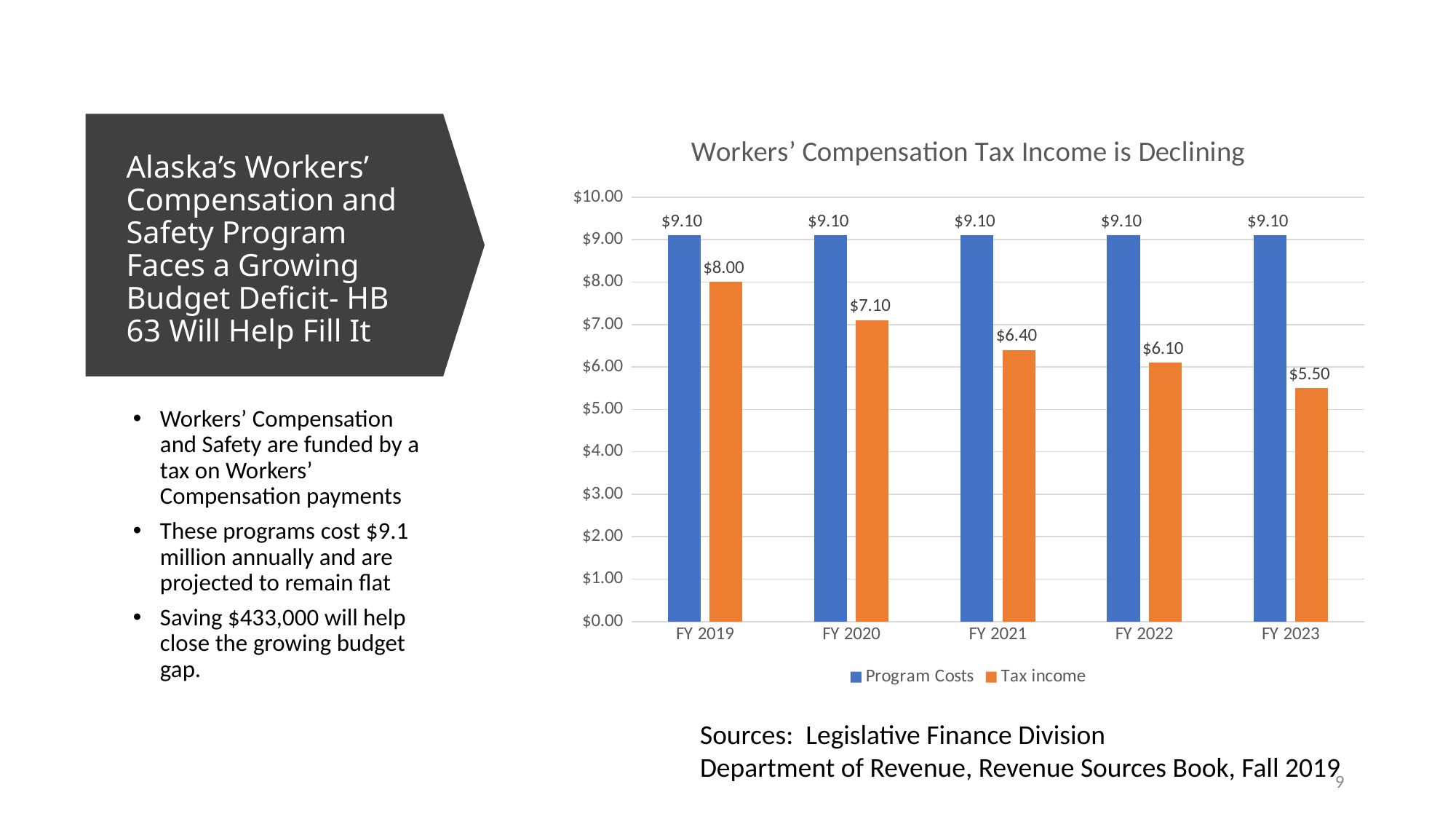
What is the difference between Program Costs and Tax income in FY 2022? $3.00 How many series does the legend list? 2 What is the Program Costs value for FY 2019? $9.10 What is the difference between Tax income in FY 2019 and FY 2023? $2.50 What is the Tax income value for FY 2023? $5.50 Which fiscal year has the highest Tax income? FY 2019 Does Tax income rise or fall from FY 2019 to FY 2023? Fall What is the Tax income value for FY 2021? $6.40 Which fiscal year has the lowest Tax income? FY 2023 Which is larger in FY 2020, Program Costs or Tax income? Program Costs What kind of chart is shown on the slide? Bar chart How many fiscal years are shown on the x axis? 5